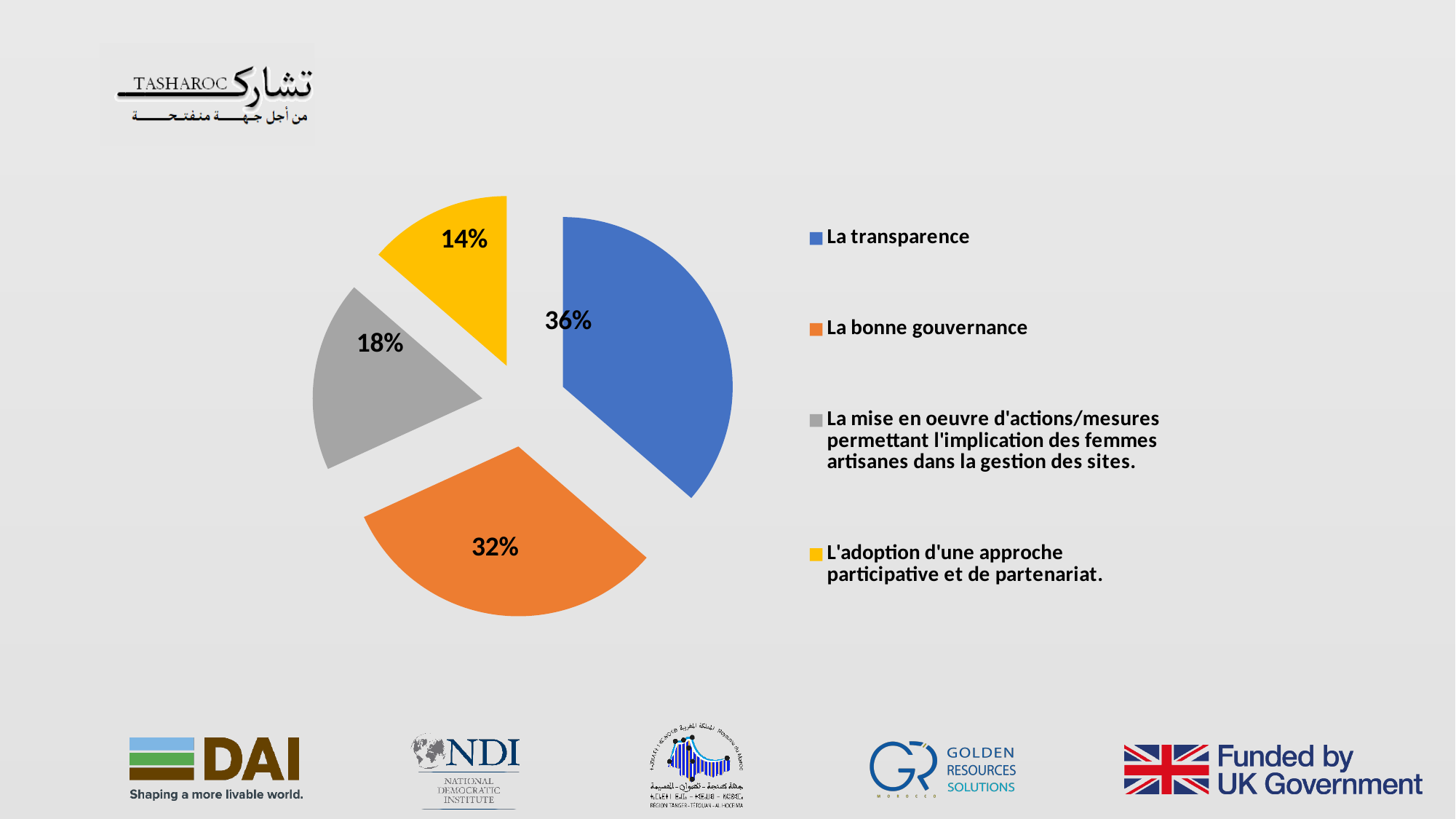
Which category has the smallest slice of the pie? L'adoption d'une approche participative et de partenariat. Which is larger: the slice for "La bonne gouvernance" or the slice for "L'adoption d'une approche participative et de partenariat."? La bonne gouvernance What colour is the slice for "La transparence"? Blue What share of the pie does "La bonne gouvernance" represent? 32% What share of the pie does "L'adoption d'une approche participative et de partenariat." represent? 14% How many slices does the pie chart have? 4 Which category has the largest slice of the pie? La transparence What kind of chart is shown on the slide? Pie chart What is the difference in percentage points between "La transparence" and "La bonne gouvernance"? 4 What colour is the slice for "La bonne gouvernance"? Orange What share of the pie does "La transparence" represent? 36% What share of the pie does "La mise en oeuvre d'actions/mesures permettant l'implication des femmes artisanes dans la gestion des sites." represent? 18%